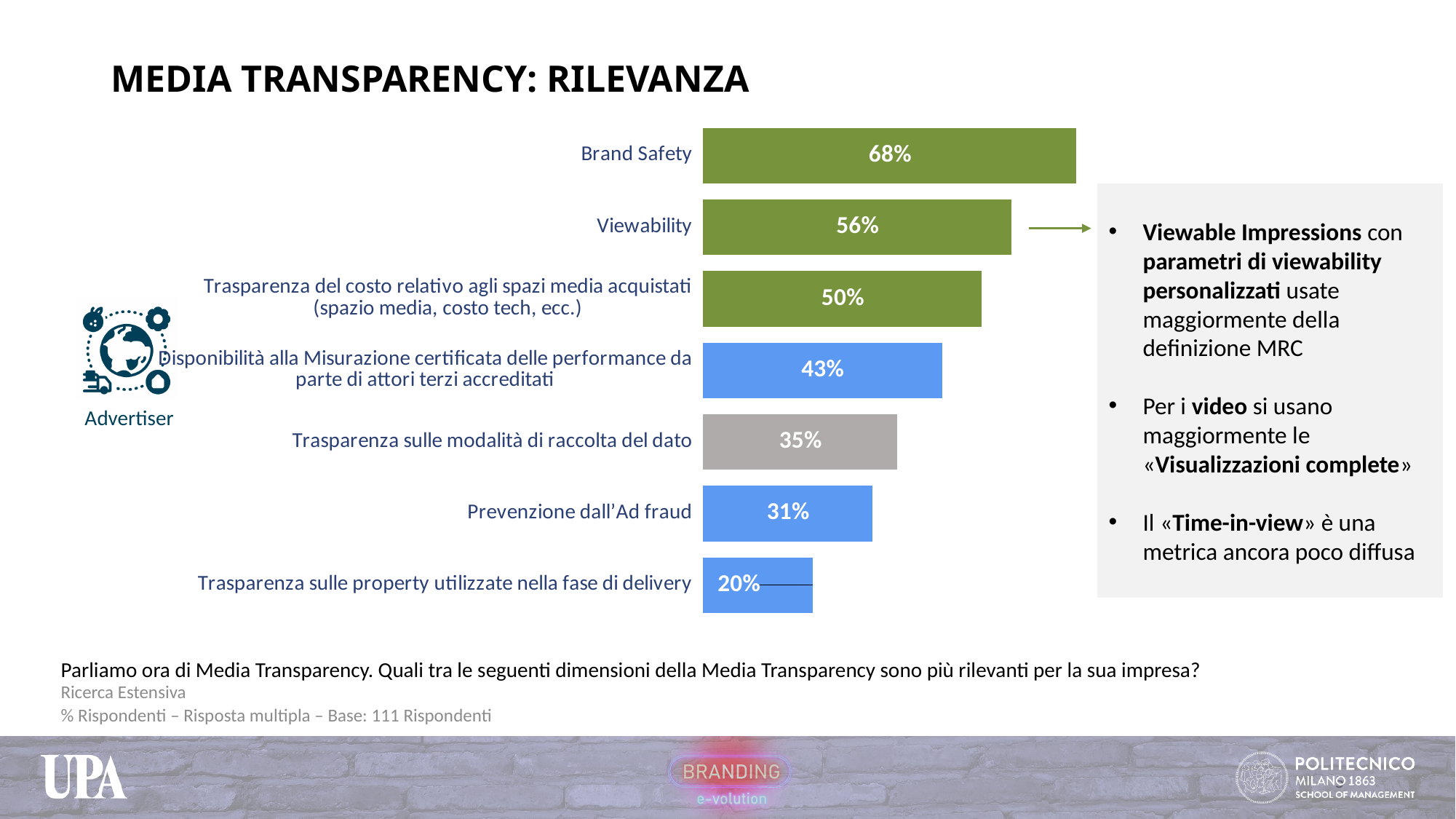
What is the difference in percentage points between Brand Safety and Viewability? 12 What is the base number of respondents stated for this chart? 111 Rispondenti Which dimension has the lowest percentage? Trasparenza sulle property utilizzate nella fase di delivery Which has a higher value: 'Trasparenza del costo relativo agli spazi media acquistati' or 'Trasparenza sulle modalità di raccolta del dato'? Trasparenza del costo relativo agli spazi media acquistati How many Media Transparency dimensions are plotted in the chart? 7 What percentage is shown for 'Prevenzione dall'Ad fraud'? 31% What is the difference between the value for 'Disponibilità alla Misurazione certificata delle performance da parte di attori terzi accreditati' and 'Prevenzione dall'Ad fraud'? 12 What is the value for 'Trasparenza sulle modalità di raccolta del dato'? 35% Which Media Transparency dimension has the highest percentage? Brand Safety What type of chart is shown on the slide? Bar chart What percentage of respondents selected Brand Safety as a relevant Media Transparency dimension? 68% What is the value shown for Viewability? 56%